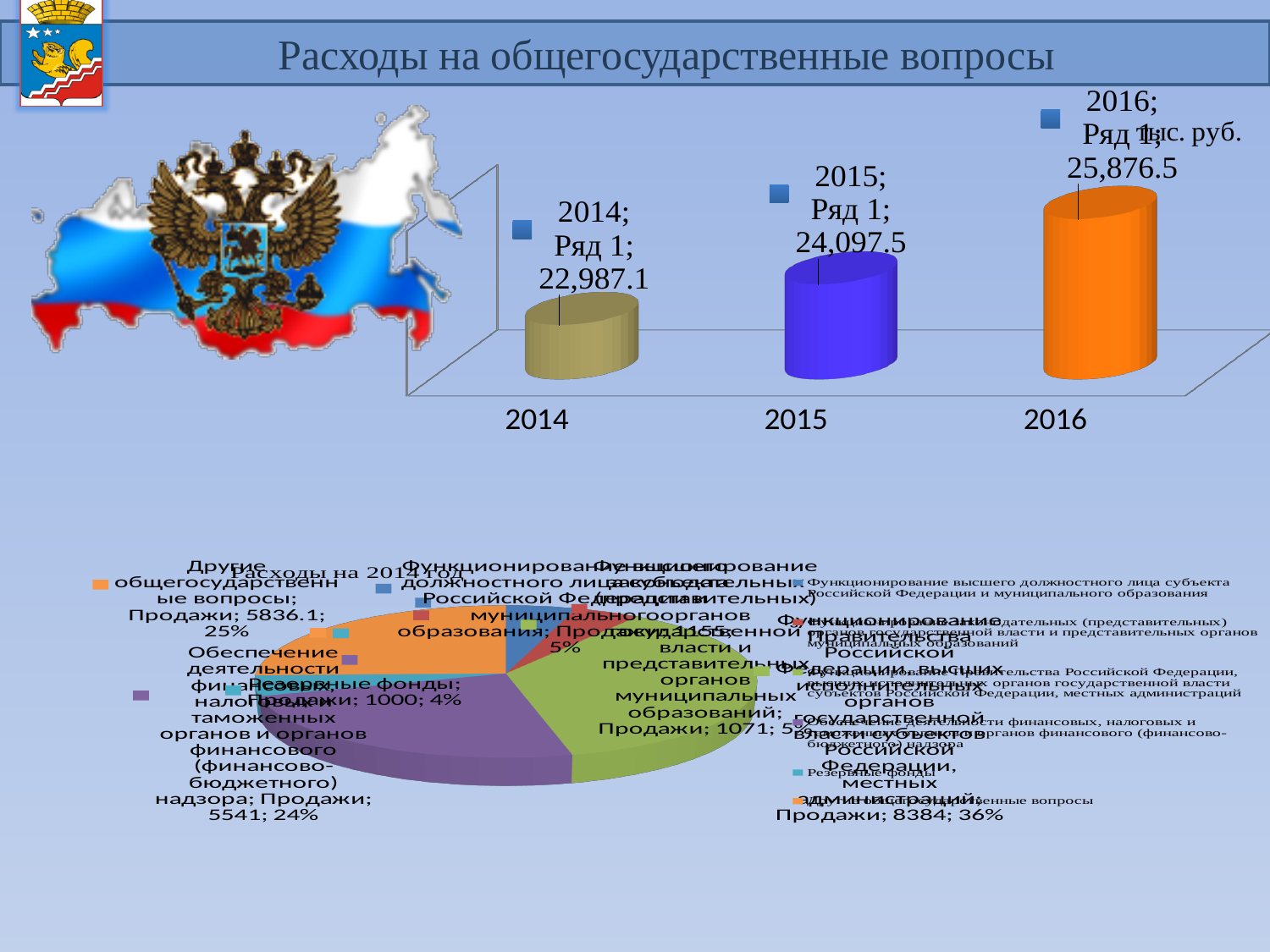
In the bar chart at the top of the slide, what is the value for 2014? 22,987.1 In the pie chart 'Расходы на 2014 год', what is the value for 'Резервные фонды'? 1000 What kind of chart is the chart at the top of the slide showing values by year? bar chart In the pie chart 'Расходы на 2014 год', what share does 'Другие общегосударственные вопросы' have? 25% In the bar chart at the top of the slide, what is the value for 2016? 25,876.5 In the pie chart 'Расходы на 2014 год', what share does 'Резервные фонды' have? 4% In the bar chart at the top of the slide, which year has the lowest value? 2014 In the bar chart at the top of the slide, what is the difference between the 2016 and 2014 values? 2,889.4 In the bar chart at the top of the slide, do the values rise or fall from 2014 to 2016? rise In the bar chart at the top of the slide, which year has the highest value? 2016 In the bar chart at the top of the slide, what is the value for 2015? 24,097.5 In the bar chart at the top of the slide, how many years are shown? 3